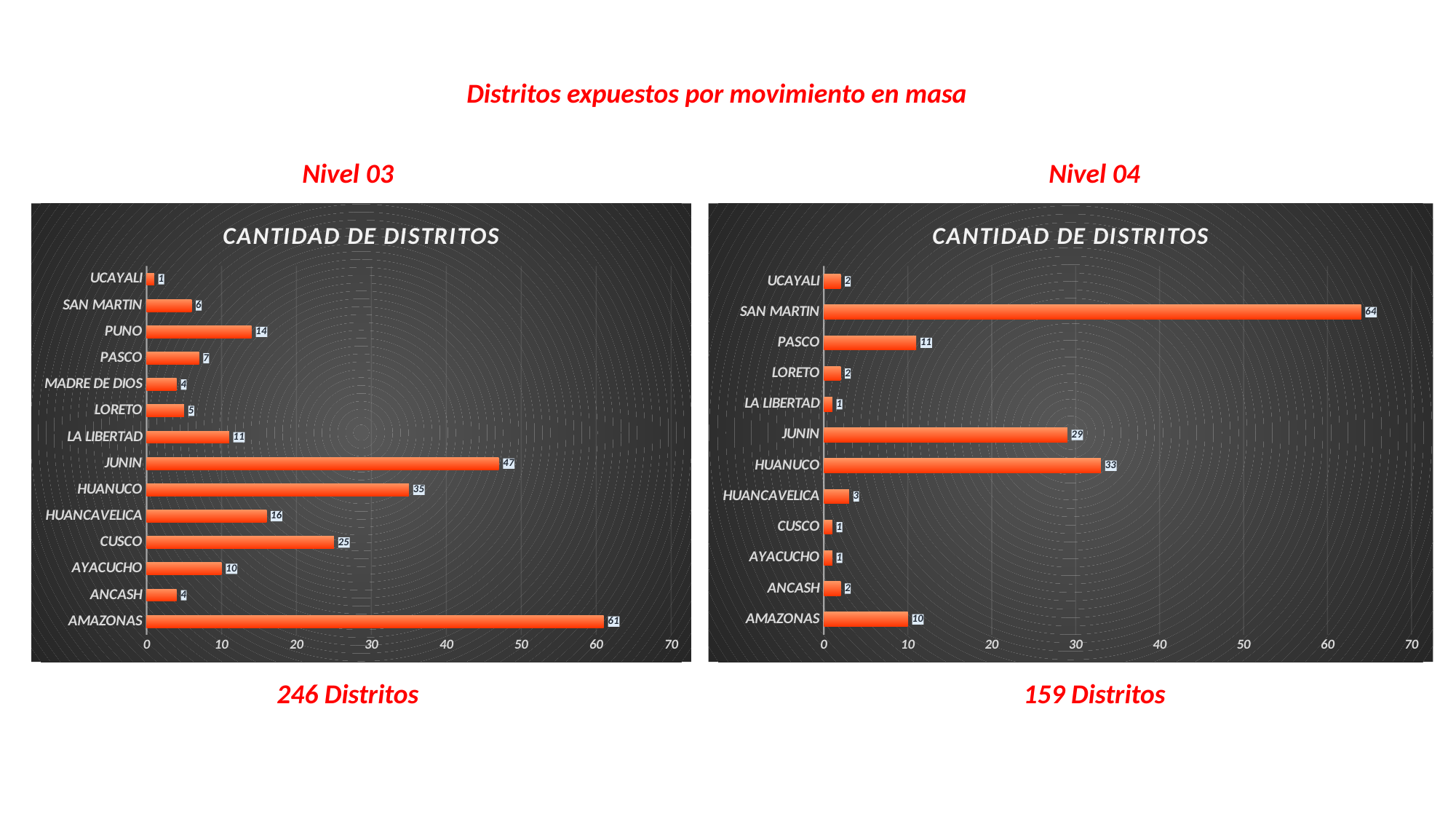
In the Nivel 03 chart, what is the difference between the values for AMAZONAS and JUNIN? 14 In the Nivel 04 chart, which region has the highest number of districts? SAN MARTIN In the Nivel 03 chart, which region has the highest number of districts? AMAZONAS In the Nivel 03 chart, is the value for HUANUCO greater or less than 30? greater How many regions are shown in the Nivel 03 chart? 14 In the Nivel 04 chart, which is larger, the value for JUNIN or the value for PASCO? JUNIN In the Nivel 04 chart, what is the difference between the values for SAN MARTIN and HUANUCO? 31 How many regions are shown in the Nivel 04 chart? 12 In the Nivel 04 chart, how many districts does HUANUCO have? 33 What type of chart is the Nivel 04 chart? Bar chart In the Nivel 03 chart, which region has the lowest number of districts? UCAYALI In the Nivel 03 chart, how many districts does JUNIN have? 47